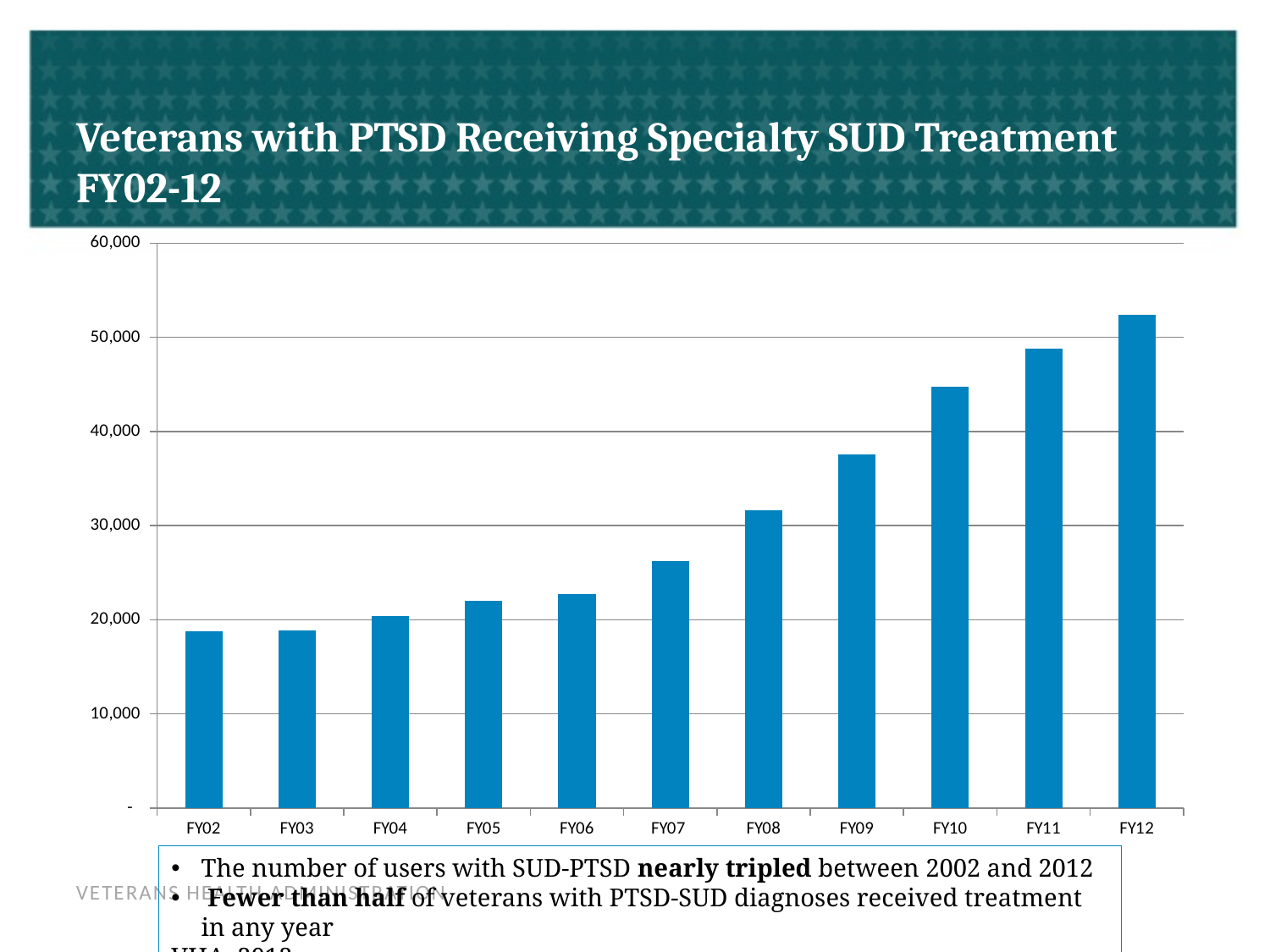
Which fiscal year has the highest value on the chart? FY12 Do the values generally rise or fall from FY02 to FY12? rise How many fiscal years are plotted on the chart? 11 Is the value for FY09 greater or less than 40,000? less Is the value for FY12 greater or less than 50,000? greater What kind of chart is shown on the slide? bar chart What is the title of the slide containing the chart? Veterans with PTSD Receiving Specialty SUD Treatment FY02-12 Is the value for FY10 greater or less than 40,000? greater Which is larger, the value for FY08 or the value for FY07? FY08